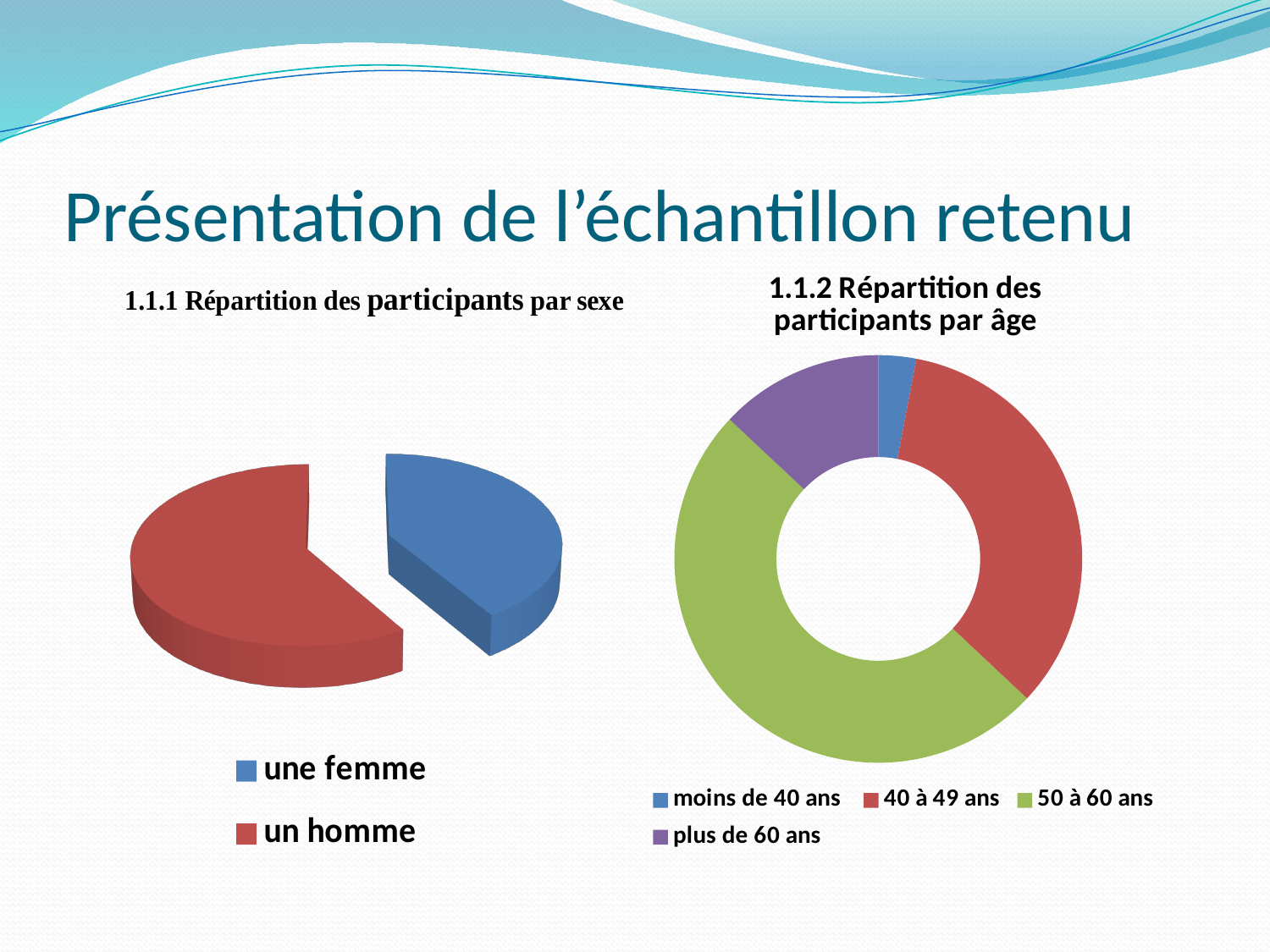
In the right chart, '1.1.2 Répartition des participants par âge', which age group has the largest share? 50 à 60 ans In the right chart, '1.1.2 Répartition des participants par âge', what colour represents the category 'plus de 60 ans'? purple What kind of chart is the right chart, '1.1.2 Répartition des participants par âge'? doughnut chart In the left chart, '1.1.1 Répartition des participants par sexe', how many categories are shown? 2 In the left chart, '1.1.1 Répartition des participants par sexe', which category has the largest slice? un homme In the left chart, '1.1.1 Répartition des participants par sexe', what colour is the slice for 'une femme'? blue In the left chart, '1.1.1 Répartition des participants par sexe', which category has the smallest slice? une femme In the right chart, '1.1.2 Répartition des participants par âge', how many categories are shown? 4 What kind of chart is the left chart, '1.1.1 Répartition des participants par sexe'? pie chart In the right chart, '1.1.2 Répartition des participants par âge', which age group has the smallest share? moins de 40 ans In the right chart, '1.1.2 Répartition des participants par âge', which is larger: 40 à 49 ans or plus de 60 ans? 40 à 49 ans In the left chart, '1.1.1 Répartition des participants par sexe', which is larger: une femme or un homme? un homme